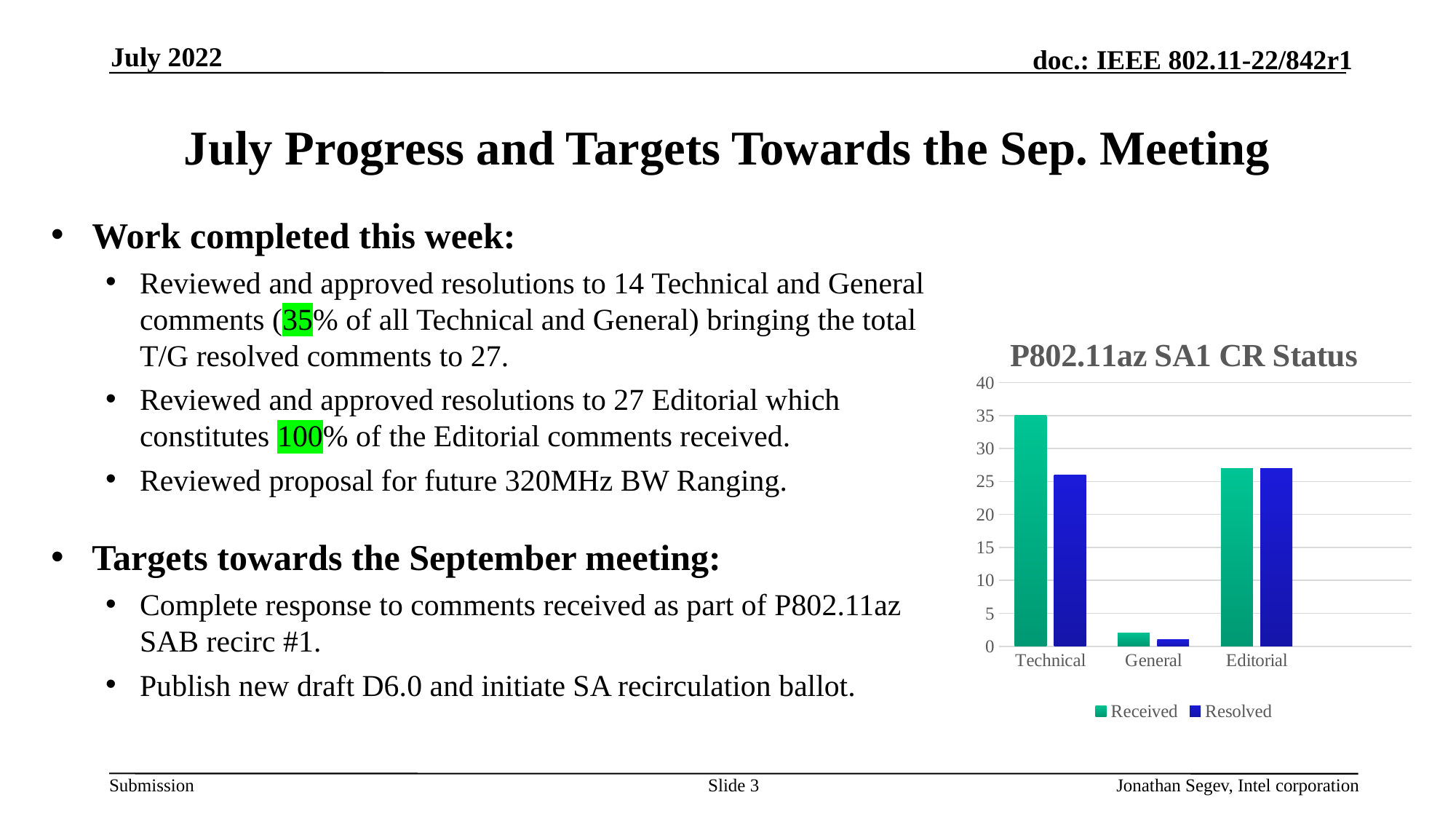
Is the Resolved value for Technical greater or less than 30? less Which category has the highest Received value? Technical Which category has the lowest Received value? General For the Technical category, which is larger: Received or Resolved? Received Which series are listed in the chart legend? Received and Resolved Which category has the lowest Resolved value? General What is the title of the chart? P802.11az SA1 CR Status What kind of chart is shown on the slide? Bar chart How many categories are shown on the x axis of the chart? 3 Is the Received value for Technical greater or less than 30? greater Is the Received value for General greater or less than 5? less How many series does the chart legend list? 2